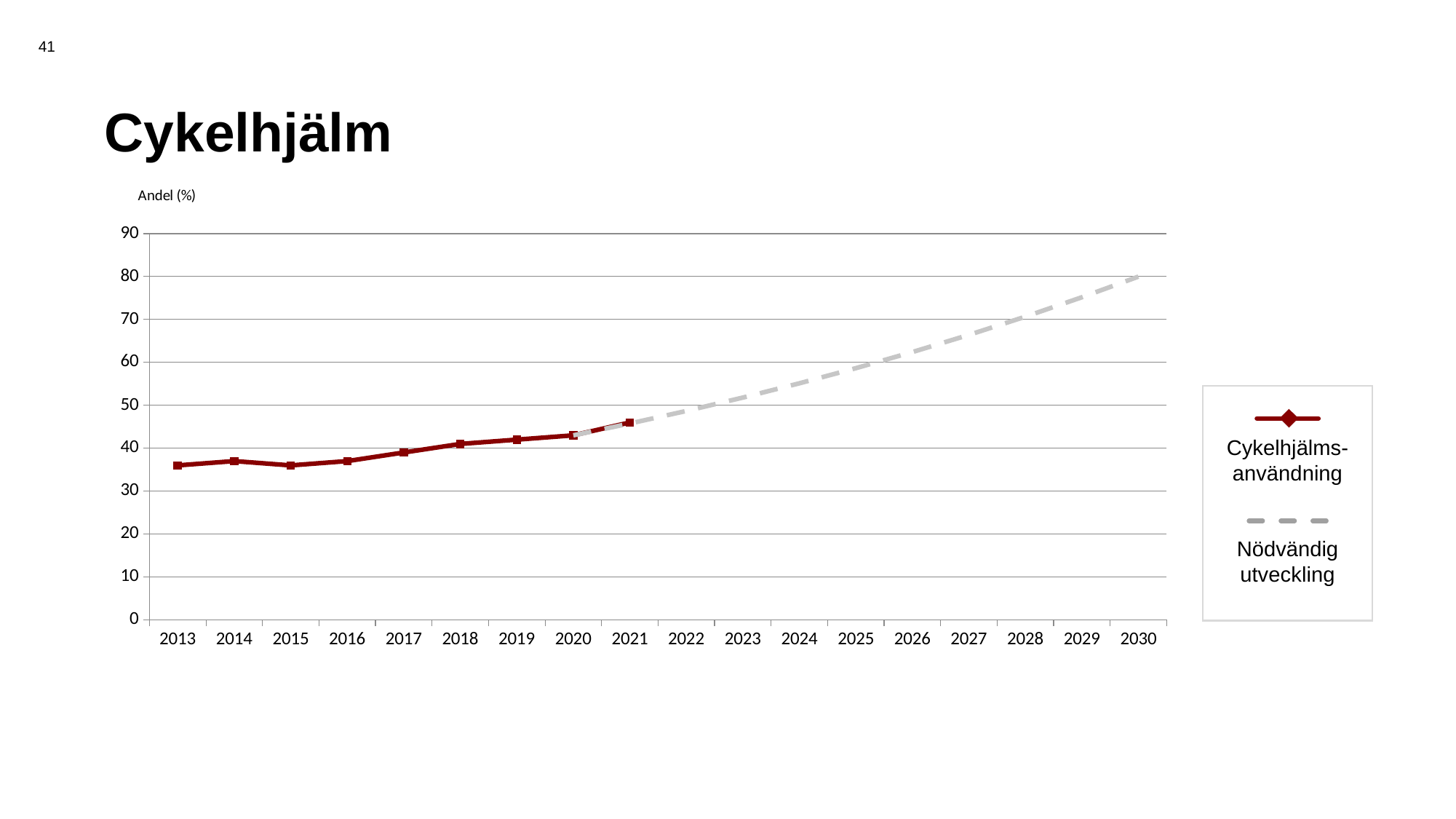
How many years are shown on the x axis? 18 Is the value for Cykelhjälms-användning in 2021 greater or less than 40? greater Is the value for Nödvändig utveckling in 2025 greater or less than 50? greater What are the two series named in the legend? Cykelhjälms-användning and Nödvändig utveckling Which is larger, Cykelhjälms-användning in 2016 or in 2019? 2019 Does the Nödvändig utveckling line rise or fall from 2021 to 2030? rise What value does the Nödvändig utveckling line reach in 2030? 80 How many series does the legend list? 2 Is the value for Cykelhjälms-användning in 2013 greater or less than 40? less What is the label on the vertical axis? Andel (%) In which year is Cykelhjälms-användning highest? 2021 What kind of chart is shown on the slide? line chart